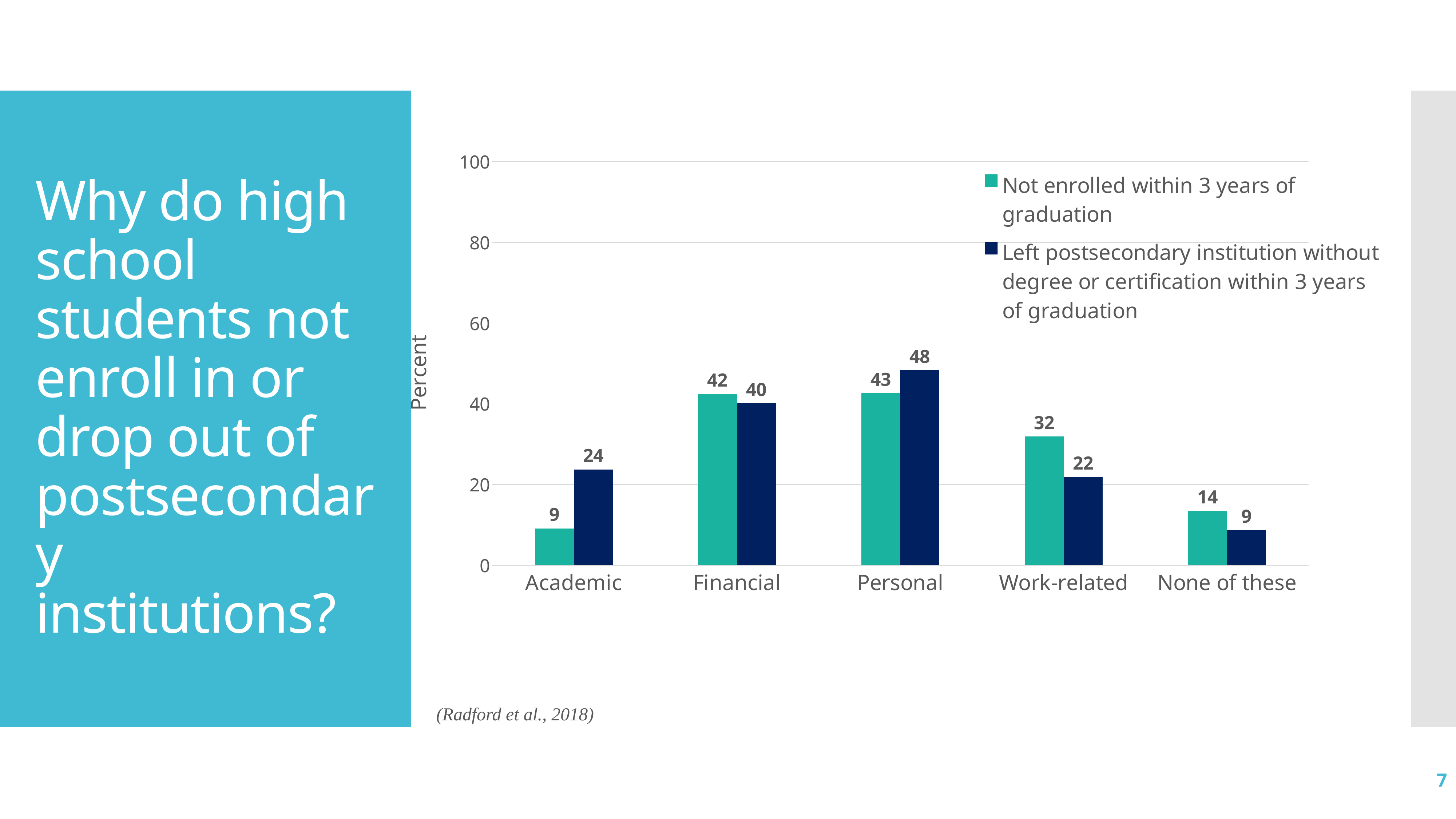
How many categories are shown on the x axis? 5 Which category has the highest value in the 'Left postsecondary institution without degree or certification within 3 years of graduation' series? Personal What is the difference between the two series' values for Work-related? 10 For Financial, which series has the larger value? Not enrolled within 3 years of graduation What is the difference between the two series' values for Academic? 15 Is the value for Personal in the 'Left postsecondary institution without degree or certification within 3 years of graduation' series greater or less than 40? greater How many series does the legend list? 2 What is the value for Work-related in the 'Not enrolled within 3 years of graduation' series? 32 Which category has the lowest value in the 'Not enrolled within 3 years of graduation' series? Academic What is the value for Personal in the 'Left postsecondary institution without degree or certification within 3 years of graduation' series? 48 What is the value for Academic in the 'Not enrolled within 3 years of graduation' series? 9 What kind of chart is shown on the slide? Bar chart